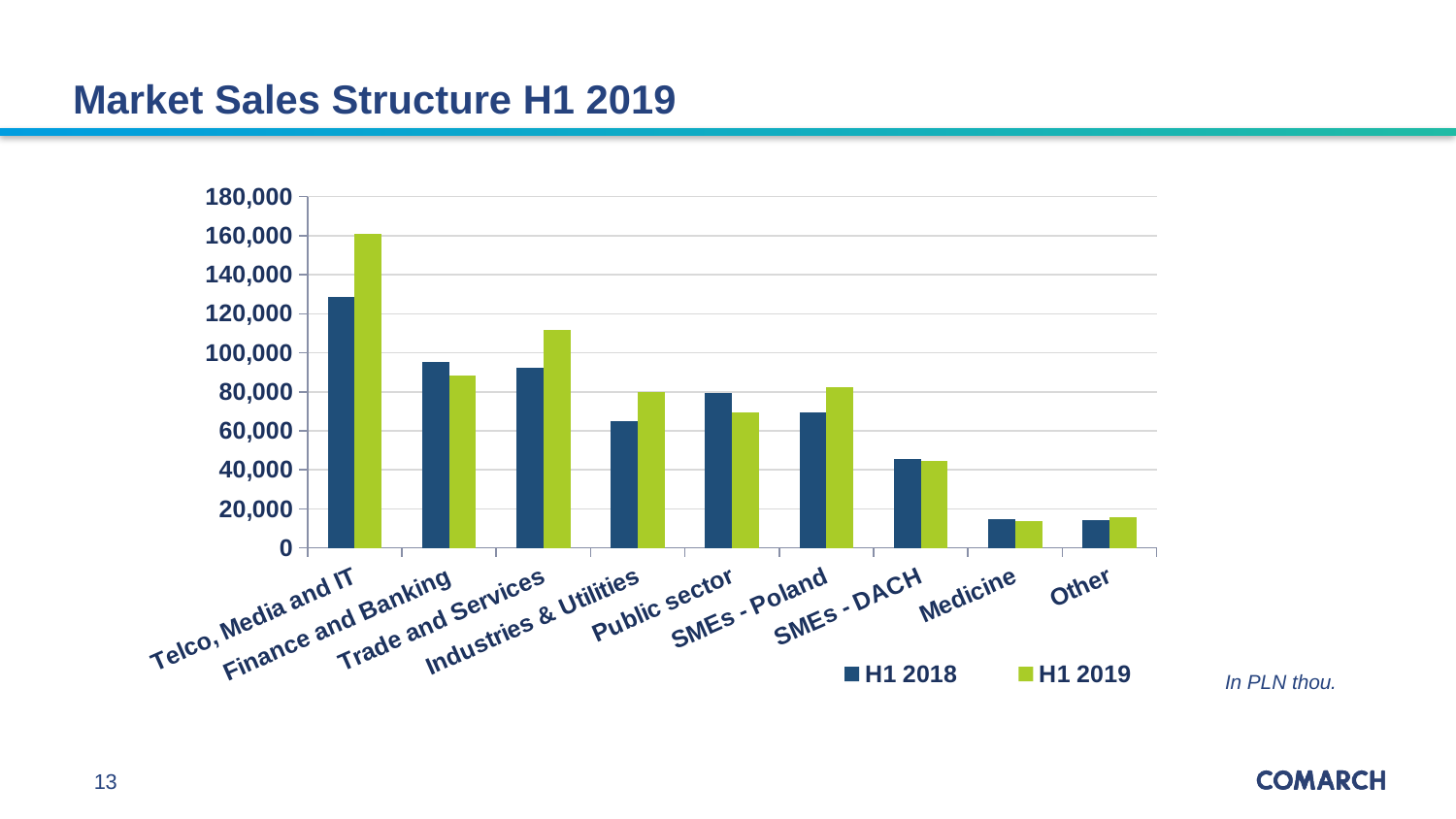
In what unit are the chart's values expressed, according to the note on the slide? In PLN thou. For Trade and Services, which is larger: the H1 2018 value or the H1 2019 value? H1 2019 Which category has the highest H1 2018 value? Telco, Media and IT What kind of chart is shown on the slide? Bar chart For Public sector, which is larger: the H1 2018 value or the H1 2019 value? H1 2018 For Finance and Banking, which is larger: the H1 2018 value or the H1 2019 value? H1 2018 Is the H1 2018 value for SMEs - DACH greater or less than 60,000? less Which category has the highest H1 2019 value? Telco, Media and IT How many market categories are shown on the x axis of the chart? 9 Is the H1 2019 value for Industries & Utilities greater or less than 100,000? less How many series does the chart's legend list? 2 Is the H1 2019 value for Telco, Media and IT greater or less than 140,000? greater